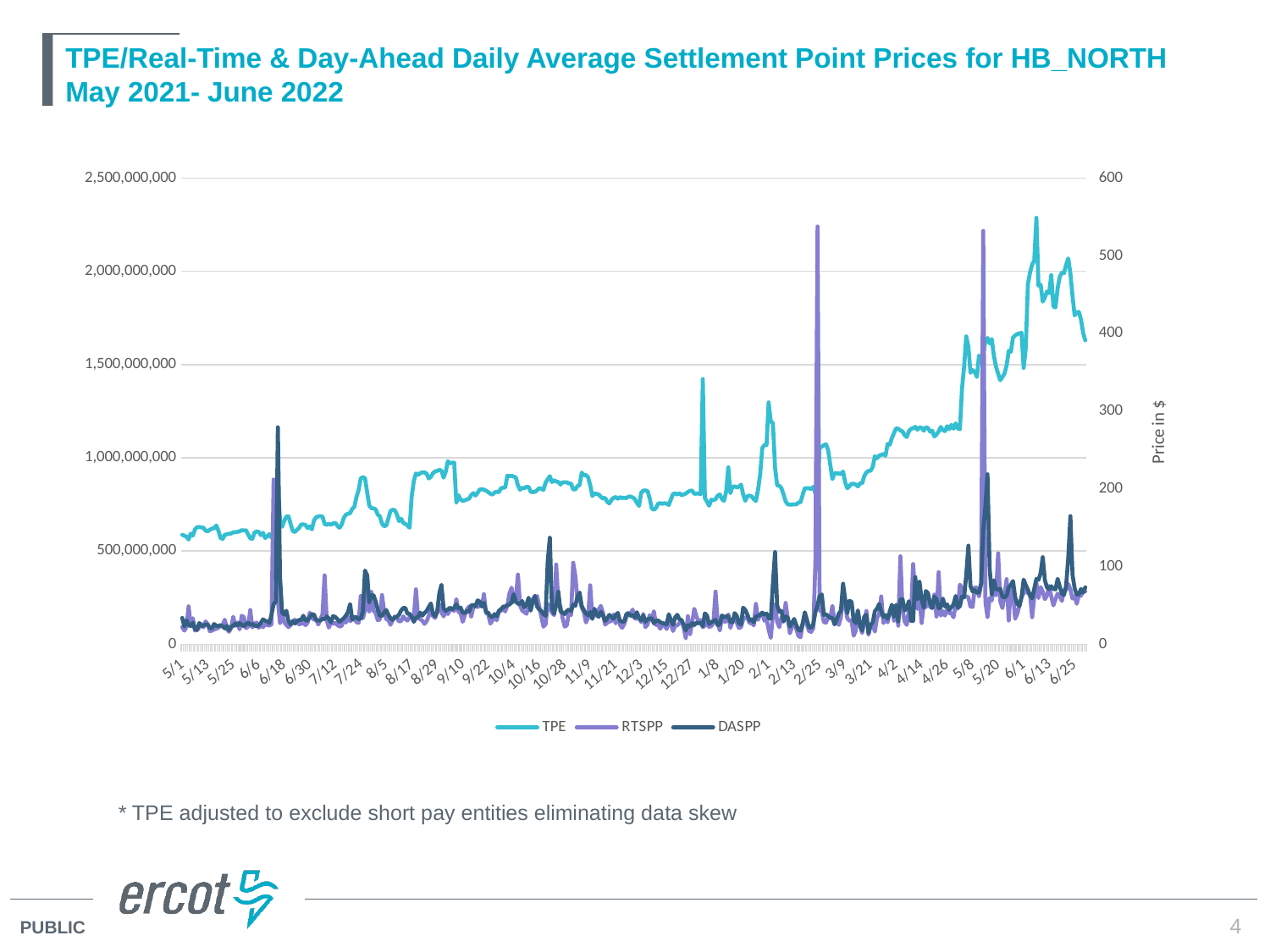
Which series reaches a higher peak on the right-hand price axis, RTSPP or DASPP? RTSPP How many series does the legend list? 3 What kind of chart is shown on the slide? Line chart Is the peak TPE value in June 2022 greater or less than 2,000,000,000? greater What are the three series named in the legend? TPE, RTSPP, DASPP What is the highest tick value shown on the right vertical axis? 600 Is the TPE value at the start of the series (5/1) greater or less than 1,000,000,000? less Does the TPE series generally rise or fall from May 2021 to June 2022? rise What is the highest tick value shown on the left vertical axis? 2,500,000,000 Is the RTSPP spike near 2/25 greater or less than 500 on the right axis? greater Which series has the highest values throughout the chart relative to the left axis? TPE What is the label of the right-hand vertical axis? Price in $